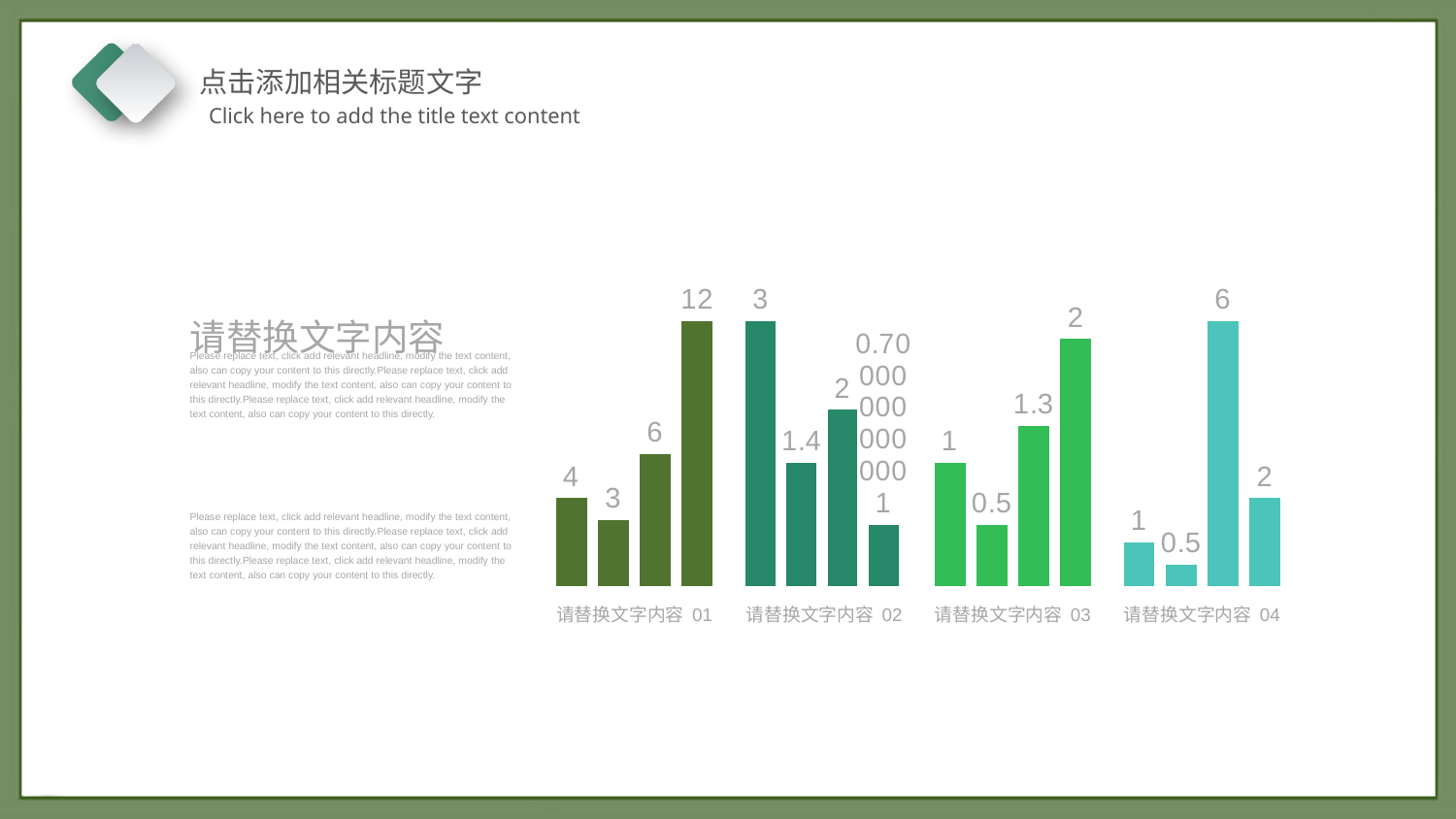
What is the value of the shortest bar in the category 请替换文字内容 04? 0.5 How many categories are shown along the x axis of the chart? 4 In the category 请替换文字内容 01, what is the difference between the tallest bar (12) and the shortest bar (3)? 9 What is the label of the last category on the x axis? 请替换文字内容 04 What is the value of the tallest bar in the category 请替换文字内容 04? 6 What is the value of the shortest bar in the category 请替换文字内容 03? 0.5 What is the value of the first bar in the category 请替换文字内容 02? 3 Which category contains the highest bar in the whole chart? 请替换文字内容 01 What is the value of the tallest bar in the category 请替换文字内容 01? 12 What kind of chart is shown on the slide? bar chart What is the difference between the tallest bar in 请替换文字内容 01 (12) and the tallest bar in 请替换文字内容 04 (6)? 6 Which is larger: the first bar of 请替换文字内容 01 or the first bar of 请替换文字内容 02? 请替换文字内容 01